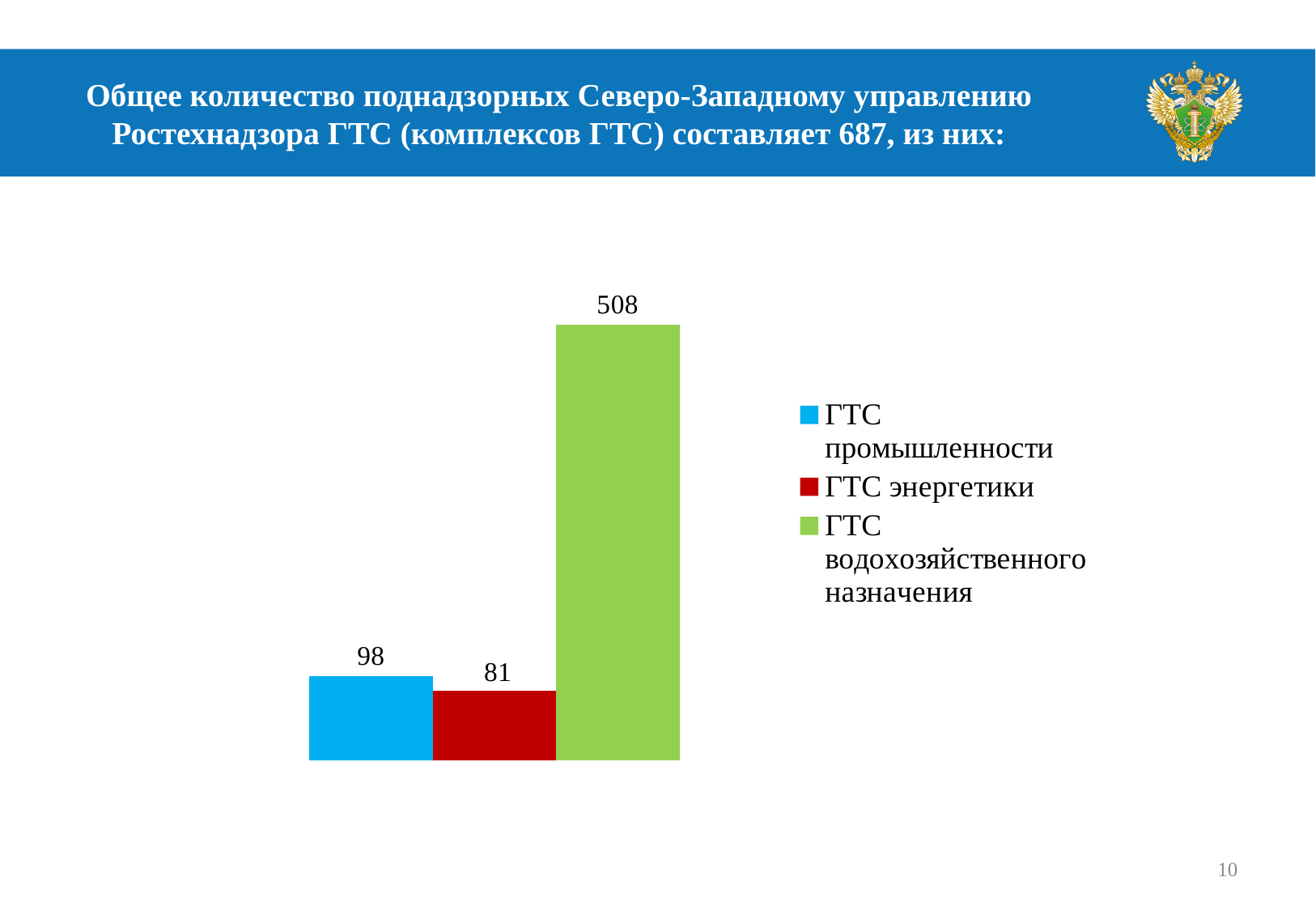
What kind of chart is shown on the slide? bar chart What is the total of the three bar values? 687 What is the difference between the values for ГТС промышленности and ГТС энергетики? 17 Which series has the highest value? ГТС водохозяйственного назначения Which series has the lowest value? ГТС энергетики What is the value for ГТС промышленности? 98 What is the difference between the values for ГТС водохозяйственного назначения and ГТС промышленности? 410 What is the value for ГТС энергетики? 81 What colour is the bar for ГТС энергетики? red How many series does the legend list? 3 Which is larger, the value for ГТС промышленности or the value for ГТС энергетики? ГТС промышленности What is the value for ГТС водохозяйственного назначения? 508